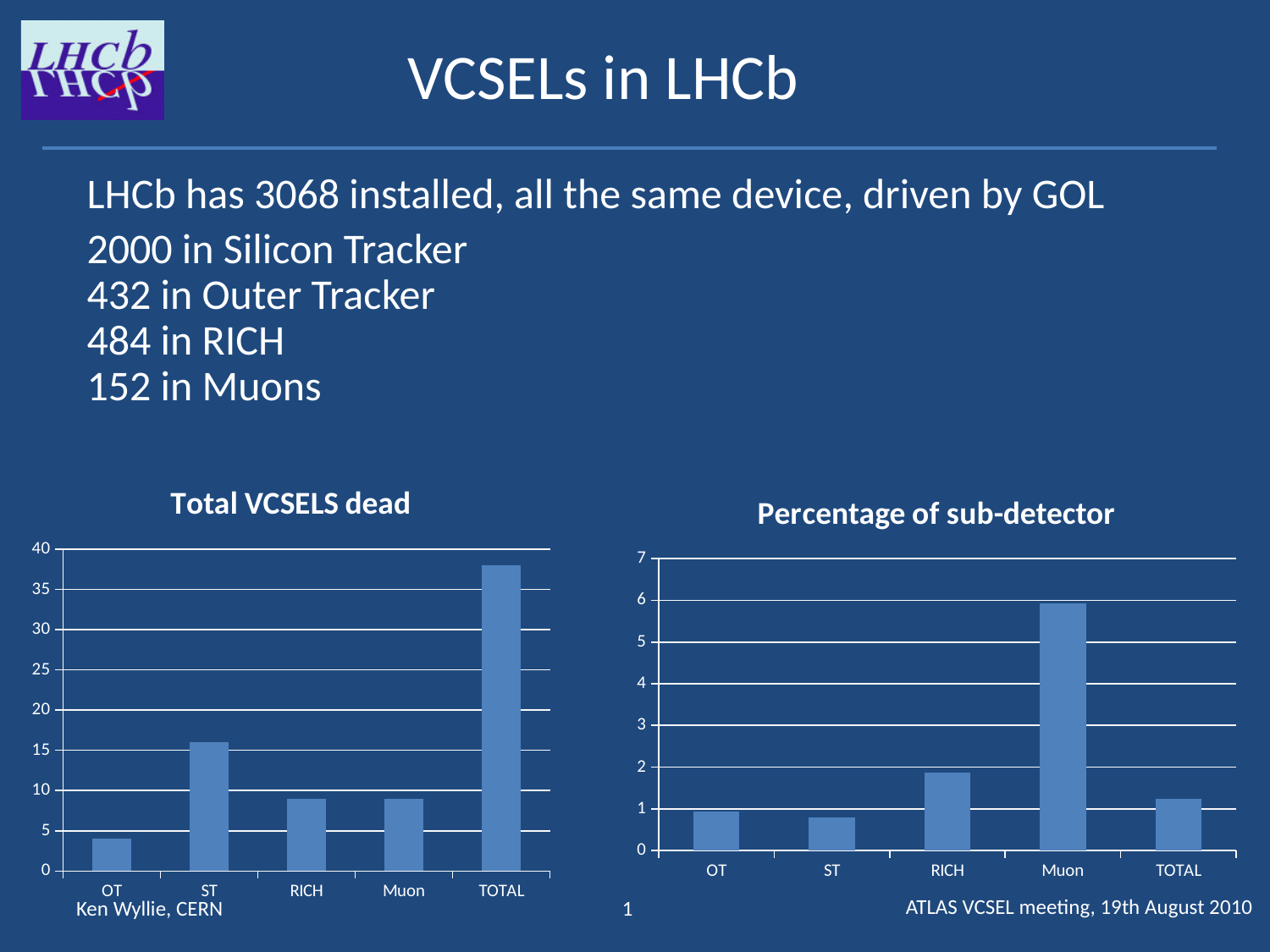
In the 'Total VCSELS dead' chart, which is larger, the value for ST or the value for RICH? ST In the 'Total VCSELS dead' chart, which category has the lowest value? OT In the 'Percentage of sub-detector' chart, which is larger, the value for RICH or the value for TOTAL? RICH How many categories are shown on the x axis of the 'Total VCSELS dead' chart? 5 What is the title of the chart on the right side of the slide? Percentage of sub-detector In the 'Total VCSELS dead' chart, is the value for OT greater or less than 5? less In the 'Percentage of sub-detector' chart, is the value for Muon greater or less than 5? greater In the 'Total VCSELS dead' chart, is the value for TOTAL greater or less than 35? greater In the 'Percentage of sub-detector' chart, which category has the highest value? Muon In the 'Total VCSELS dead' chart, which category has the highest value? TOTAL What kind of chart is the 'Total VCSELS dead' chart? bar chart